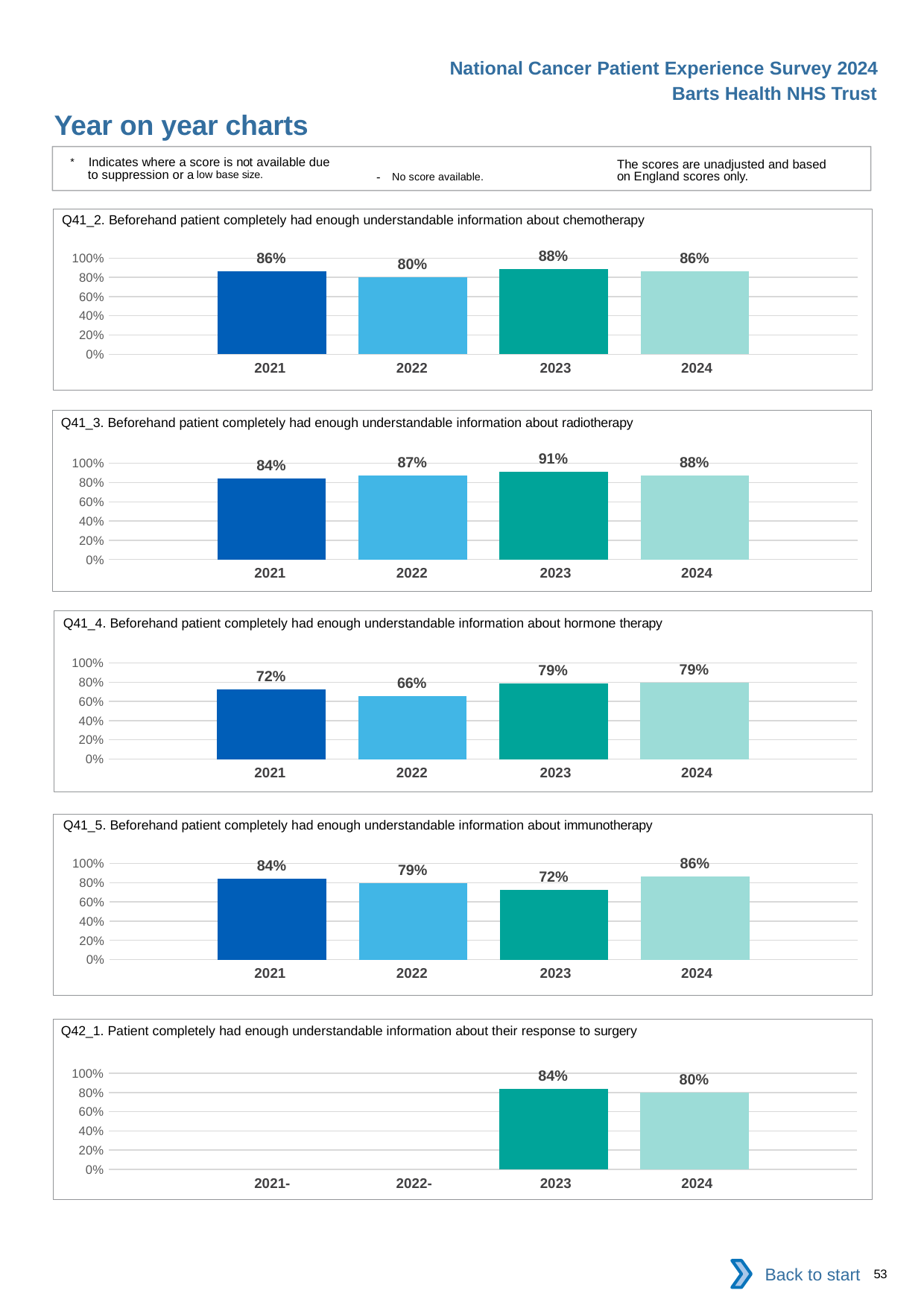
In the Q41_4 chart (information about hormone therapy), what is the value for 2024? 79% In the Q41_5 chart (information about immunotherapy), which is larger, the value for 2021 or the value for 2023? 2021 In the Q42_1 chart (information about response to surgery), how many years have a bar plotted? 2 In the Q41_5 chart (information about immunotherapy), what is the difference between the 2024 and 2023 values? 14 percentage points In the Q41_3 chart (information about radiotherapy), what is the value for 2023? 91% In the Q41_4 chart (information about hormone therapy), which year has the lowest value? 2022 In the Q42_1 chart (information about response to surgery), what is the value for 2024? 80% What type of chart is the Q41_2 chart (information about chemotherapy)? Bar chart In the Q41_2 chart (information about chemotherapy), what is the value for 2022? 80% In the Q41_2 chart (information about chemotherapy), which year has the highest value? 2023 In the Q41_3 chart (information about radiotherapy), what is the difference between the 2023 and 2021 values? 7 percentage points How many charts are shown on the slide? 5